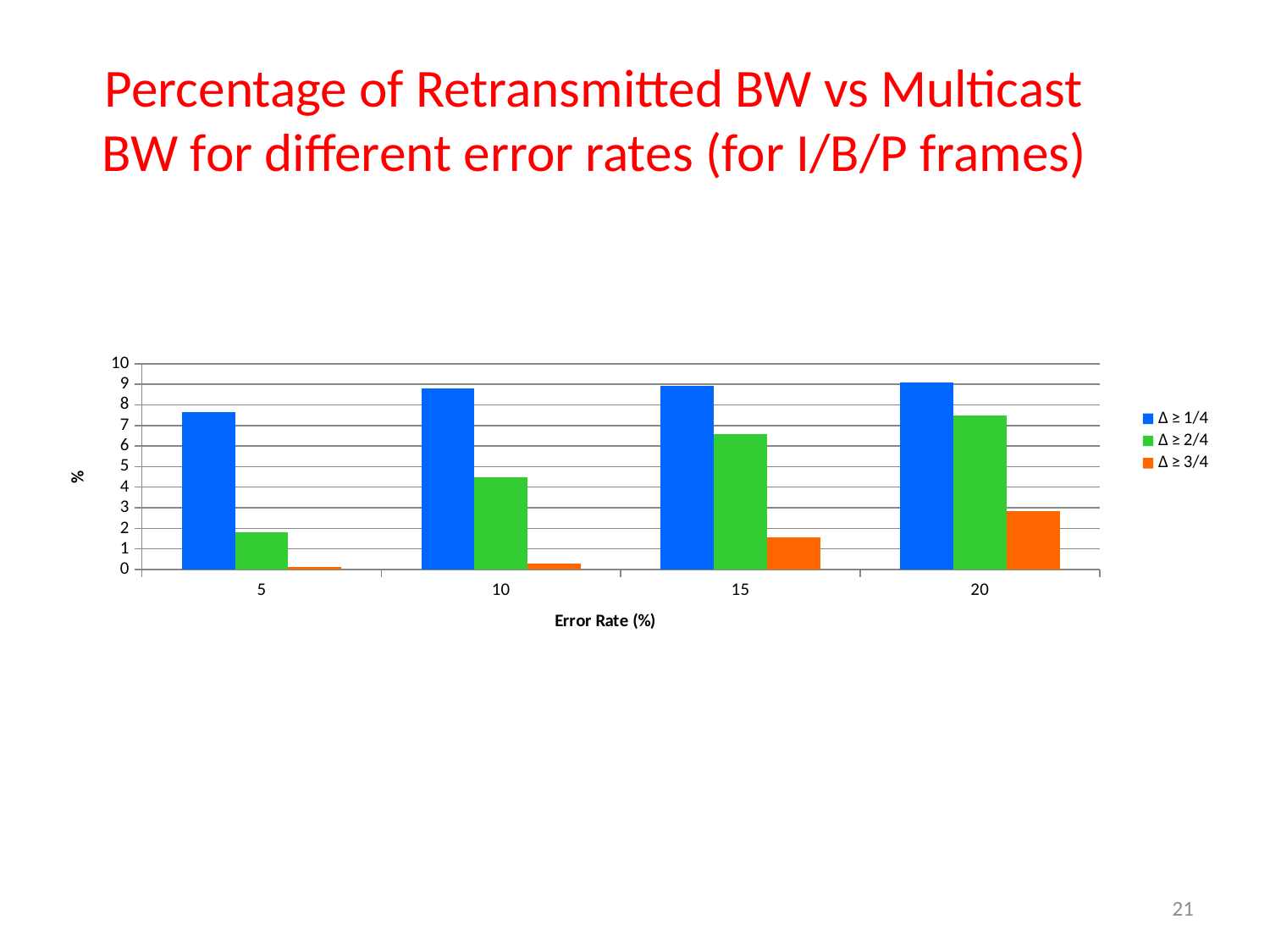
How many error rate categories are shown on the x axis? 4 What kind of chart is shown on the slide? bar chart At an error rate of 15, which is larger: the Δ ≥ 2/4 value or the Δ ≥ 3/4 value? Δ ≥ 2/4 Is the value for Δ ≥ 2/4 at an error rate of 10 greater or less than 5? less Is the value for Δ ≥ 3/4 at an error rate of 20 greater or less than 3? less Do the Δ ≥ 2/4 values rise or fall as the error rate increases from 5 to 20? rise Is the value for Δ ≥ 1/4 at an error rate of 5 greater or less than 7? greater At which error rate is the Δ ≥ 1/4 value lowest? 5 At which error rate is the Δ ≥ 2/4 value highest? 20 How many series does the legend list? 3